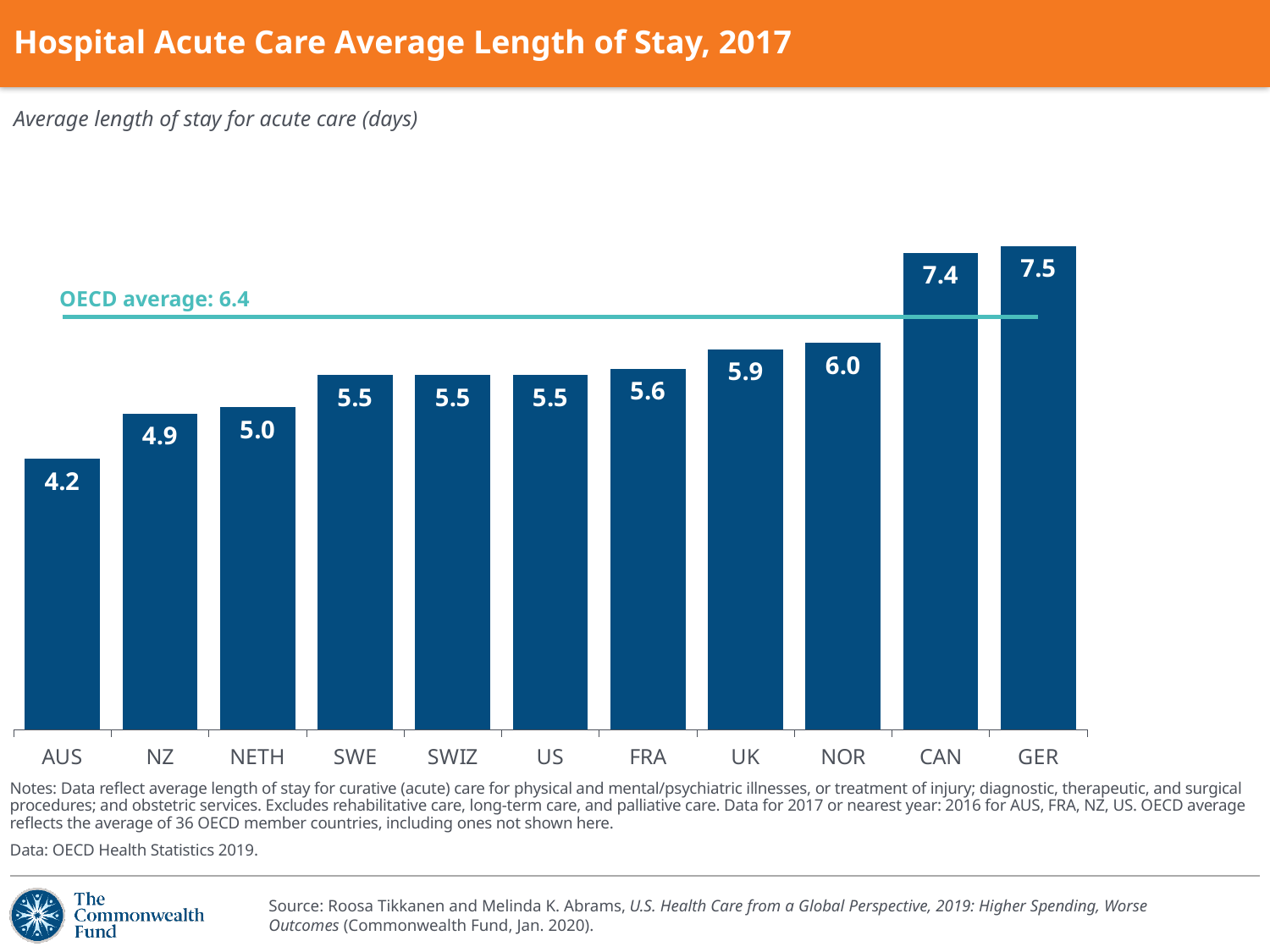
What is the average length of stay for acute care in the US? 5.5 Which has a longer average length of stay, NOR or NZ? NOR Which country has the highest average length of stay for acute care? GER How many countries are shown in the chart? 11 What is the title of the chart? Hospital Acute Care Average Length of Stay, 2017 What type of chart is shown on the slide? Bar chart What is the average length of stay for acute care in CAN? 7.4 Do the values rise or fall moving from left to right along the x axis? Rise How many countries have an average length of stay above the OECD average of 6.4? 2 What is the difference in average length of stay between GER and AUS? 3.3 Which country has the lowest average length of stay for acute care? AUS What is the OECD average length of stay shown on the chart? 6.4